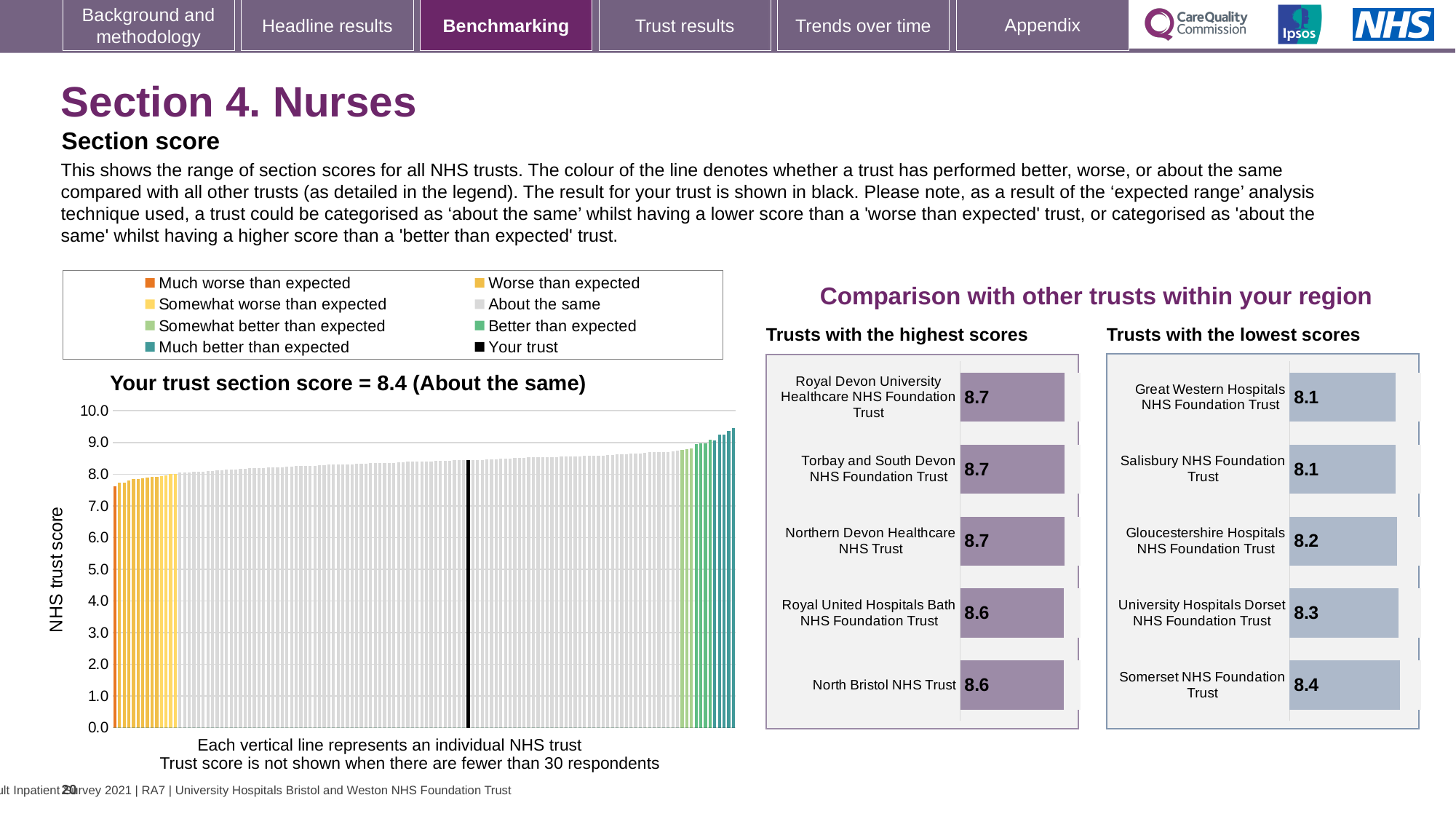
In the 'Trusts with the lowest scores' chart, which trust has the highest score? Somerset NHS Foundation Trust In the 'Trusts with the lowest scores' chart, what is the difference between the scores of Somerset NHS Foundation Trust and Great Western Hospitals NHS Foundation Trust? 0.3 What is the y-axis label of the main chart on the left? NHS trust score What type of chart is the main chart on the left showing all NHS trusts? Bar chart In the 'Trusts with the lowest scores' chart, which has the larger score: Gloucestershire Hospitals NHS Foundation Trust or University Hospitals Dorset NHS Foundation Trust? University Hospitals Dorset NHS Foundation Trust In the 'Trusts with the highest scores' chart, what is the score for North Bristol NHS Trust? 8.6 In the 'Trusts with the lowest scores' chart, what is the score for Gloucestershire Hospitals NHS Foundation Trust? 8.2 In the main chart on the left, do the trust scores rise or fall from left to right along the x axis? Rise In the main chart on the left, what is the section score for your trust, as stated in the chart title? 8.4 How many entries does the legend above the main chart list? 8 In the 'Trusts with the highest scores' chart, what is the score for Royal Devon University Healthcare NHS Foundation Trust? 8.7 How many trusts are shown in the 'Trusts with the highest scores' chart? 5